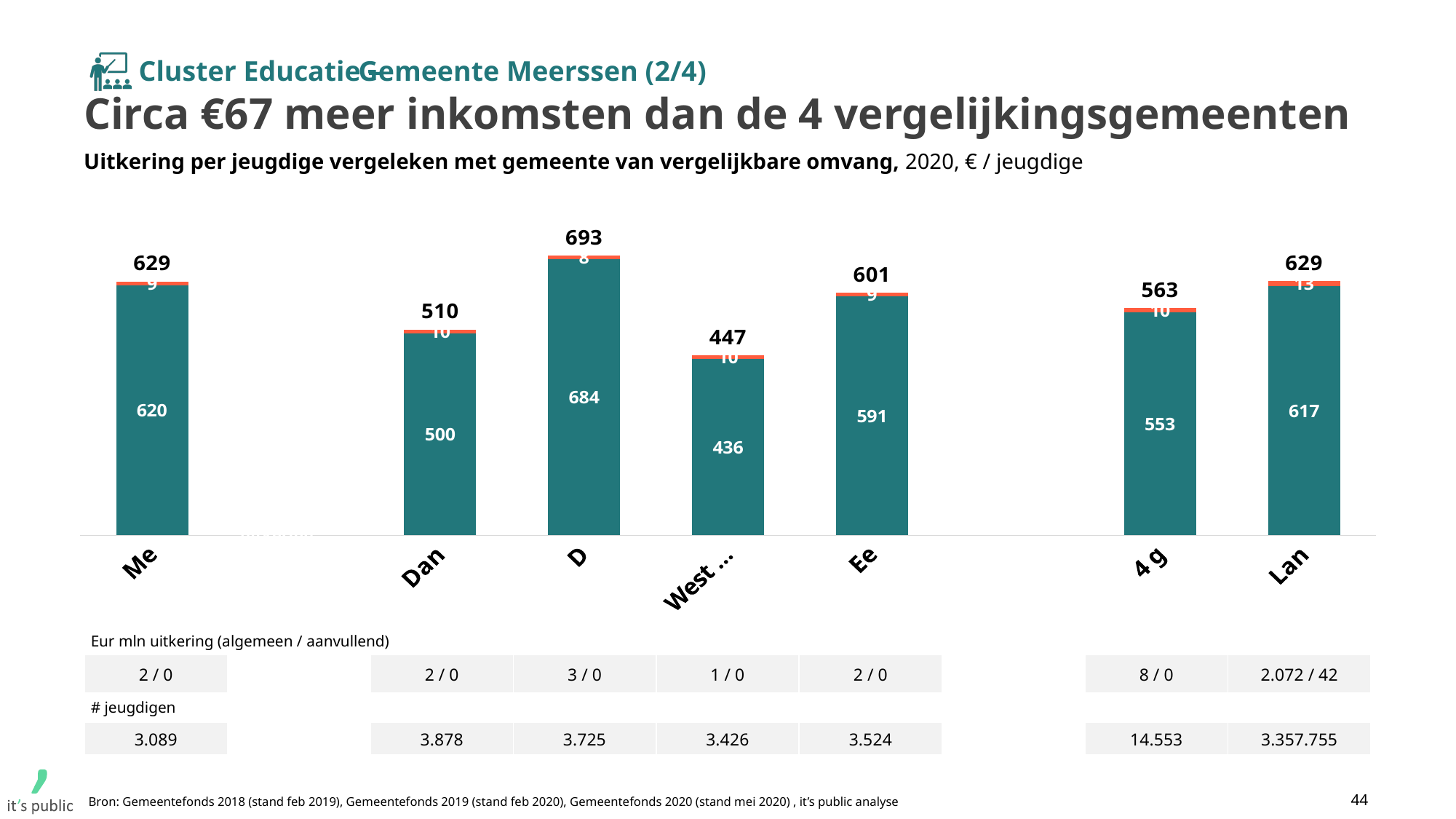
Which category has the lowest total value? West ... What is the total value shown above the bar for 'West ...'? 447 Which category has the highest total value? D What is the value of the teal (lower) segment of the bar for '4 g'? 553 What is the total value shown above the bar for 'Ee'? 601 What kind of chart is shown on the slide? Stacked bar chart What is the value of the teal (lower) segment of the bar for 'Me'? 620 What is the difference between the teal segment of 'Me' (620) and the teal segment of '4 g' (553)? 67 What is the total value shown above the bar for 'D'? 693 What is the difference between the total for 'D' and the total for 'West ...'? 246 How many bars are plotted in the chart? 7 Which has a larger total value, 'Dan' or 'Ee'? Ee